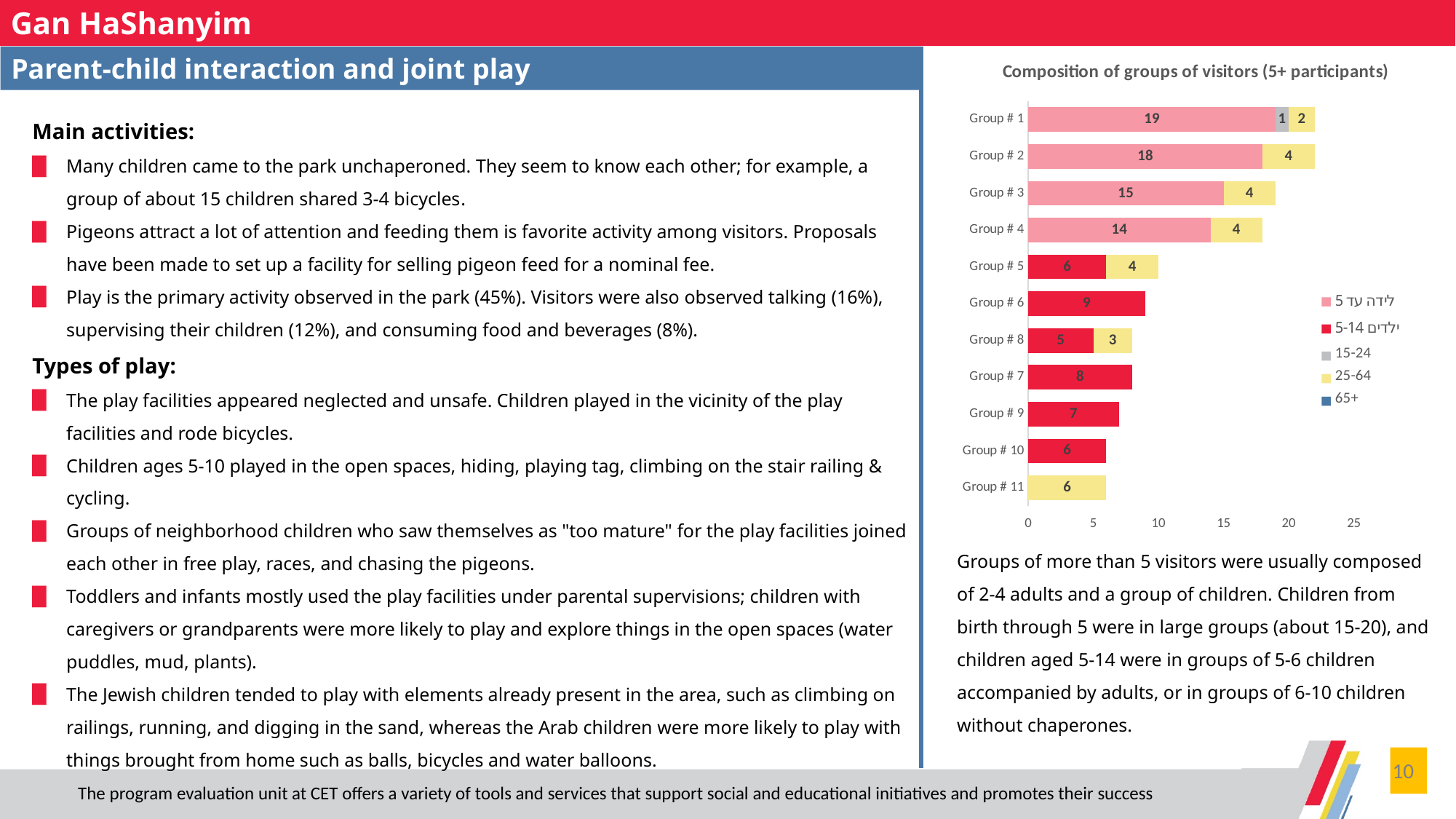
What is the difference between the largest segment of Group # 1 and the largest segment of Group # 4? 5 What is the total of the stacked bar for Group # 1? 22 Is the total bar for Group # 3 greater or less than 15? greater What is the value of the 25-64 series for Group # 2? 4 What is the value of the 25-64 series for Group # 8? 3 What is the total of the stacked bar for Group # 5? 10 How many groups are listed on the chart's vertical axis? 11 How many series does the chart legend list? 5 What is the title of the chart? Composition of groups of visitors (5+ participants) Which group has the shortest total bar? Group # 10 and Group # 11 (tied at 6) What is the value of the 15-24 series for Group # 1? 1 What kind of chart is shown on the slide? Stacked bar chart